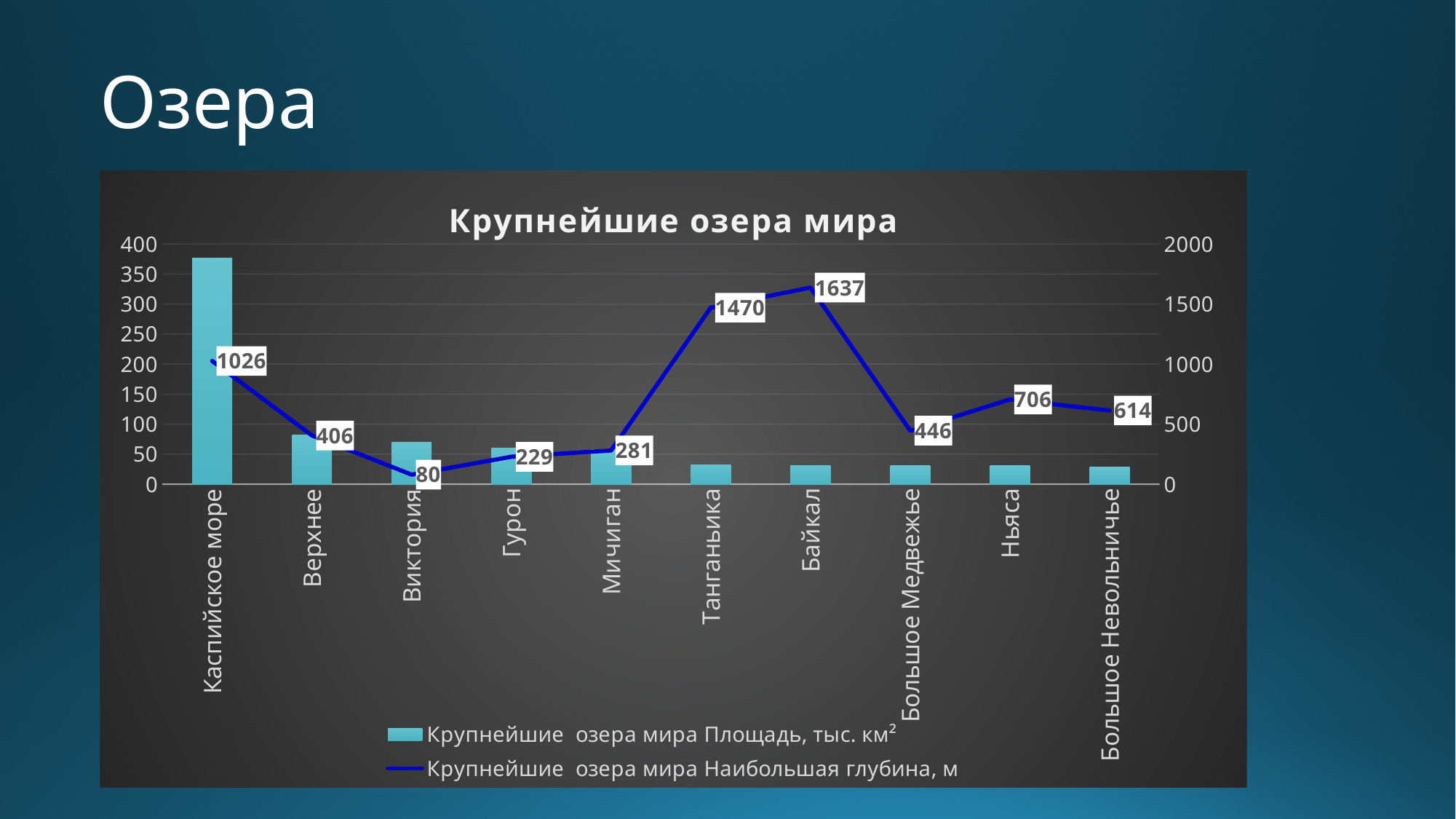
Which lake has the greatest maximum depth on the chart? Байкал What kind of chart is shown on the slide? Combination bar and line chart Which lake has the smallest maximum depth on the chart? Виктория What is the maximum depth (Наибольшая глубина, м) shown for Байкал? 1637 Which lake has a greater maximum depth, Ньяса or Большое Невольничье? Ньяса How many series does the legend list? 2 What is the maximum depth (Наибольшая глубина, м) shown for Каспийское море? 1026 Is the area bar (Площадь, тыс. км²) for Каспийское море greater or less than 350? greater What is the maximum depth (Наибольшая глубина, м) shown for Виктория? 80 What is the difference in maximum depth between Байкал and Танганьика? 167 How many lakes are shown on the chart? 10 Is the area bar (Площадь, тыс. км²) for Верхнее greater or less than 100? less